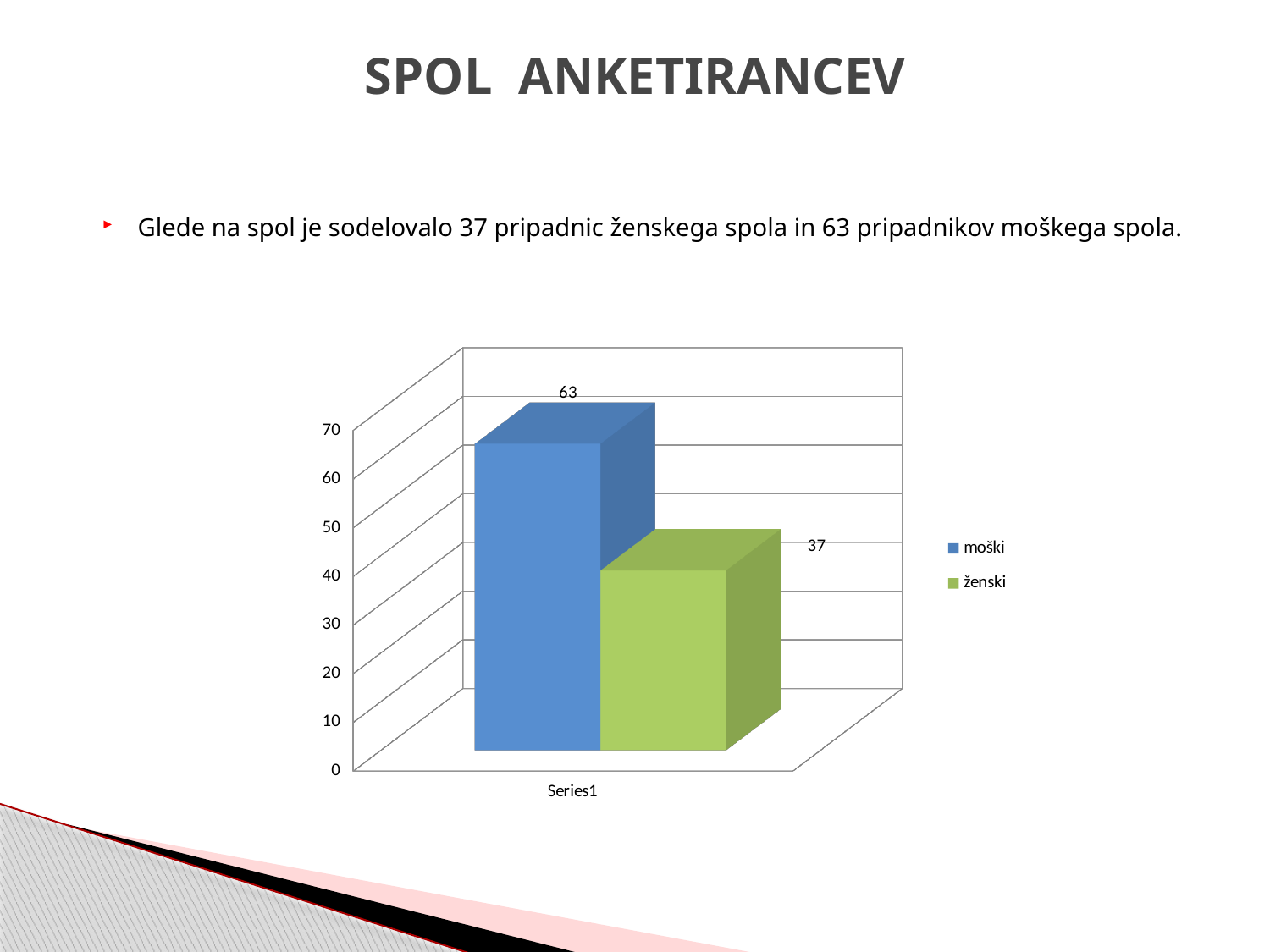
Which series has the lowest value? ženski Is the value for ženski greater or less than 40? less What is the difference between the values for moški and ženski? 26 Which is larger, the value for ženski or the value for moški? moški What is the total of the values for moški and ženski? 100 Is the value for moški greater or less than 60? greater Which series has the highest value, moški or ženski? moški What is the value for moški? 63 What colour is the bar for ženski? green What kind of chart is shown on the slide? bar chart How many series does the legend list? 2 What is the value for ženski? 37